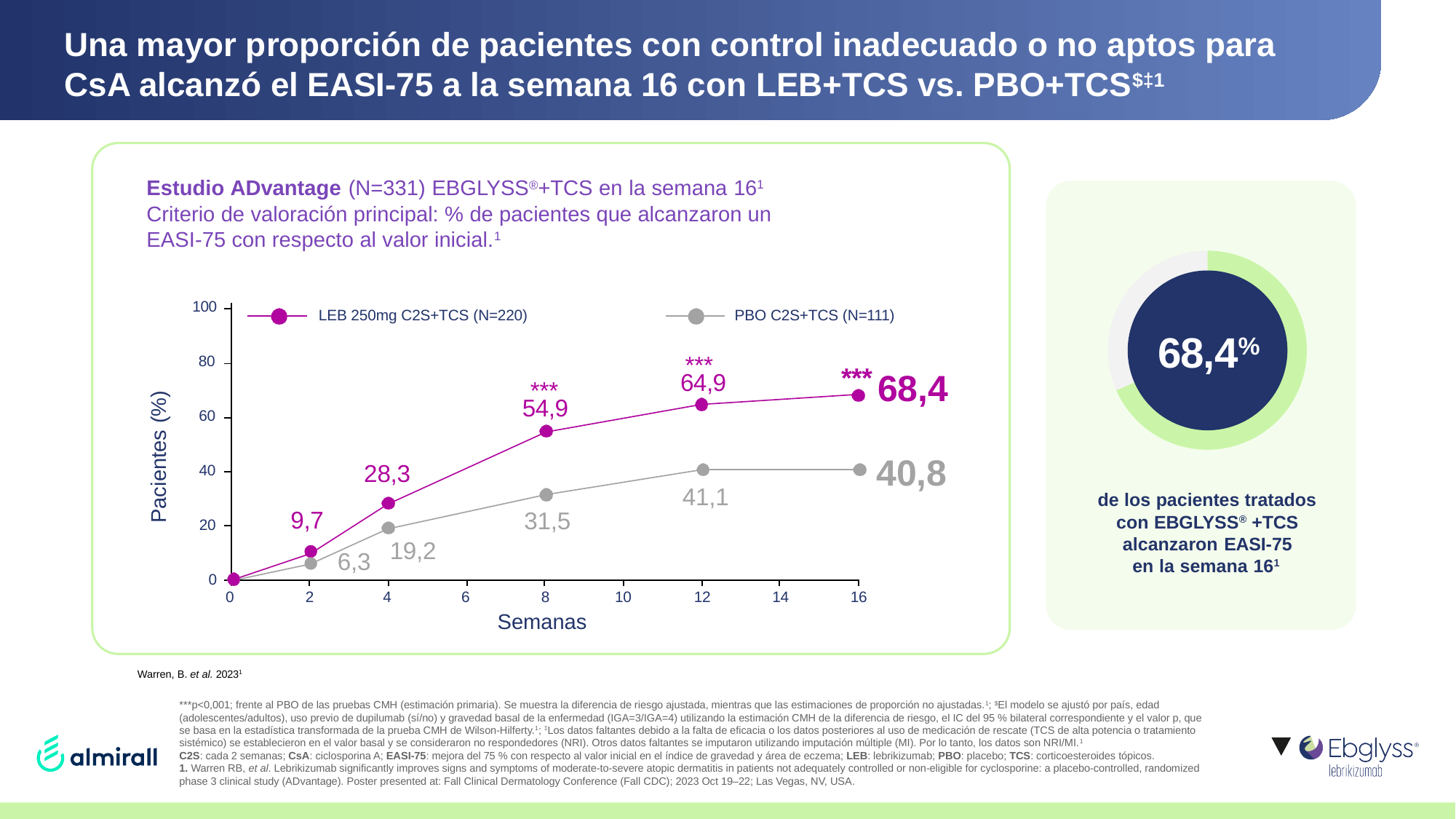
In the line chart, what is the value for LEB 250mg C2S+TCS at week 16? 68,4 What kind of chart is the chart on the left of the slide? Line chart In the line chart, what is the difference between LEB 250mg C2S+TCS and PBO C2S+TCS at week 16? 27,6 In the line chart, at which week does the PBO C2S+TCS series reach its highest value? 12 In the line chart, which series has the higher value at week 8, LEB 250mg C2S+TCS or PBO C2S+TCS? LEB 250mg C2S+TCS In the line chart, what is the value for LEB 250mg C2S+TCS at week 4? 28,3 In the line chart, what is the value for PBO C2S+TCS at week 2? 6,3 What percentage is shown in the centre of the donut chart on the right of the slide? 68,4% In the line chart, what is the difference between LEB 250mg C2S+TCS and PBO C2S+TCS at week 12? 23,8 In the line chart, what is the value for PBO C2S+TCS at week 8? 31,5 In the line chart, does the LEB 250mg C2S+TCS series rise or fall from week 0 to week 16? Rise How many series does the legend of the line chart list? 2